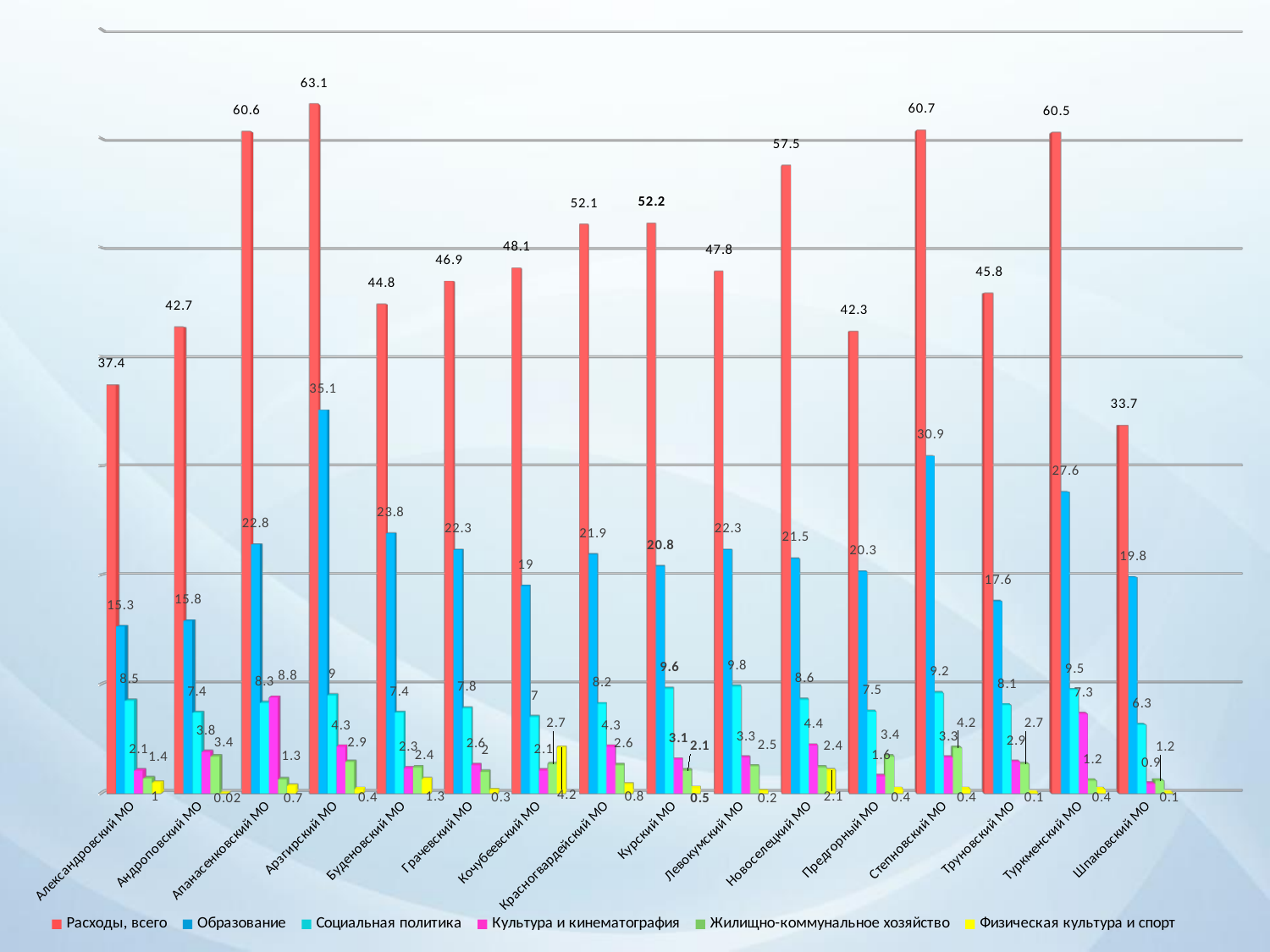
How many series does the legend list? 6 What is the value of 'Социальная политика' for Курский МО? 9.6 Which municipal district has the lowest value for 'Расходы, всего'? Шпаковский МО What is the value of 'Образование' for Степновский МО? 30.9 What type of chart is shown on the slide? bar chart How many municipal districts (categories) are shown on the x axis? 16 Which municipal district has the highest value for 'Образование'? Арзгирский МО What is the value of 'Расходы, всего' for Арзгирский МО? 63.1 What is the difference between 'Расходы, всего' for Степновский МО and Апанасенковский МО? 0.1 Which is larger: 'Образование' for Туркменский МО or for Буденовский МО? Туркменский МО Which municipal district has the highest value for 'Расходы, всего'? Арзгирский МО What colour are the bars for the series 'Физическая культура и спорт'? yellow